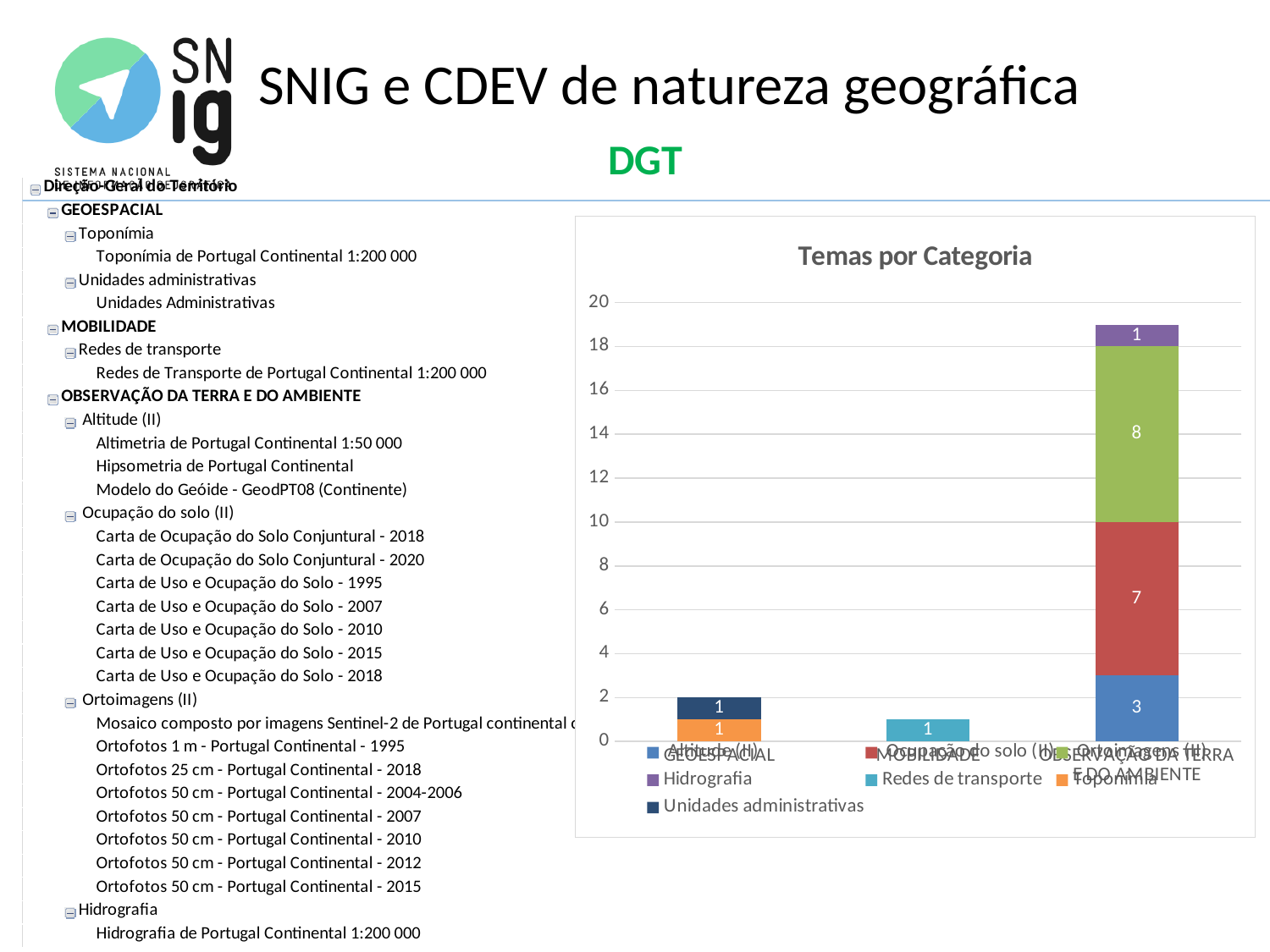
What type of chart is shown on the slide? stacked bar chart What is the value of Redes de transporte for MOBILIDADE? 1 What is the total of the stacked bar for OBSERVAÇÃO DA TERRA E DO AMBIENTE? 19 What is the value of Ortoimagens (II) for OBSERVAÇÃO DA TERRA E DO AMBIENTE? 8 How many categories are shown on the x axis of the chart? 3 What is the difference between the Ortoimagens (II) value and the Altitude (II) value for OBSERVAÇÃO DA TERRA E DO AMBIENTE? 5 What is the total of the stacked bar for GEOESPACIAL? 2 What is the value of Ocupação do solo (II) for OBSERVAÇÃO DA TERRA E DO AMBIENTE? 7 What is the title of the chart? Temas por Categoria Which category has the highest total? OBSERVAÇÃO DA TERRA E DO AMBIENTE How many series does the chart legend list? 7 What is the value of Altitude (II) for OBSERVAÇÃO DA TERRA E DO AMBIENTE? 3